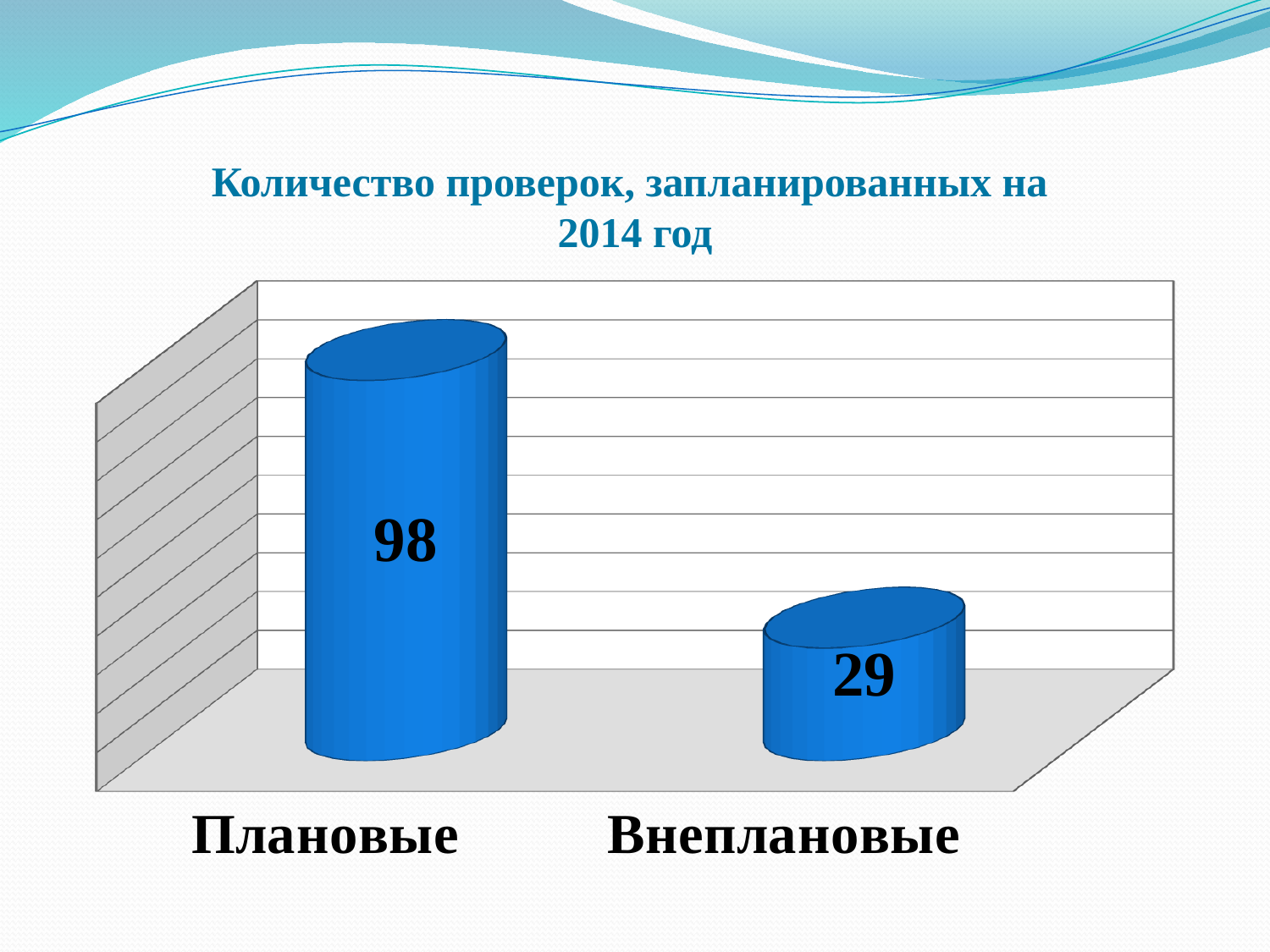
What is the title of the chart? Количество проверок, запланированных на 2014 год What is the difference between the values for Плановые and Внеплановые? 69 What kind of chart is shown on the slide? Bar chart What is the total of the two values shown in the chart? 127 How many categories are shown in the chart? 2 What is the value for Плановые? 98 Which category has the highest value? Плановые Which category has the lowest value? Внеплановые What is the value for Внеплановые? 29 Which is larger, the value for Плановые or the value for Внеплановые? Плановые What colour are the bars in the chart? Blue